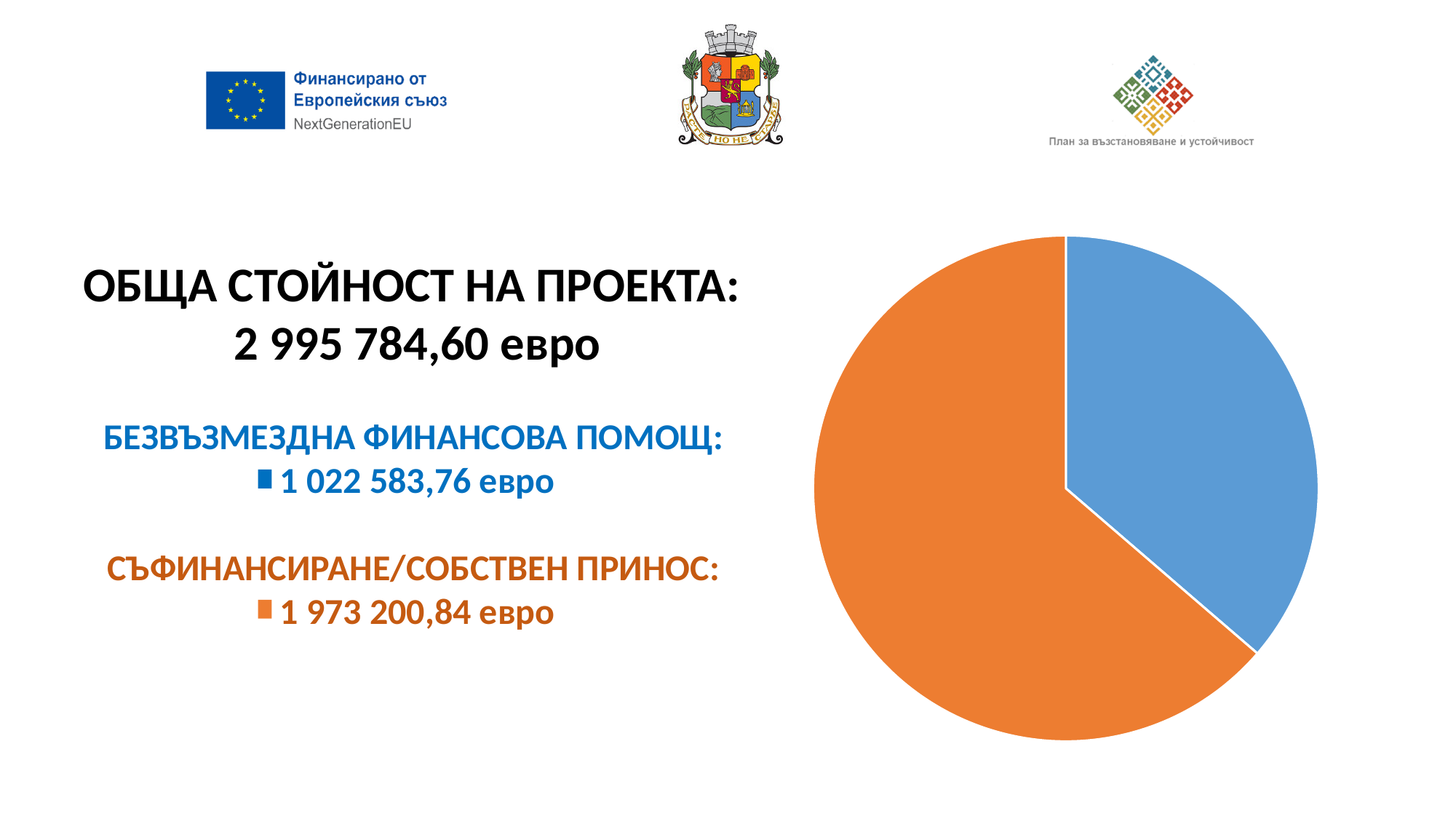
What is the difference between the value for СЪФИНАНСИРАНЕ/СОБСТВЕН ПРИНОС and the value for БЕЗВЪЗМЕЗДНА ФИНАНСОВА ПОМОЩ? 950 617,08 евро Which category has the largest slice of the pie? СЪФИНАНСИРАНЕ/СОБСТВЕН ПРИНОС How many slices does the pie chart have? 2 Which category has the smallest slice of the pie? БЕЗВЪЗМЕЗДНА ФИНАНСОВА ПОМОЩ What is the value for БЕЗВЪЗМЕЗДНА ФИНАНСОВА ПОМОЩ (the blue slice)? 1 022 583,76 евро What is the value for СЪФИНАНСИРАНЕ/СОБСТВЕН ПРИНОС (the orange slice)? 1 973 200,84 евро What kind of chart is shown on the slide? pie chart What colour is the slice for БЕЗВЪЗМЕЗДНА ФИНАНСОВА ПОМОЩ? blue What is the total value represented by the whole pie (ОБЩА СТОЙНОСТ НА ПРОЕКТА)? 2 995 784,60 евро What colour is the slice for СЪФИНАНСИРАНЕ/СОБСТВЕН ПРИНОС? orange Which category has the larger slice of the pie: БЕЗВЪЗМЕЗДНА ФИНАНСОВА ПОМОЩ or СЪФИНАНСИРАНЕ/СОБСТВЕН ПРИНОС? СЪФИНАНСИРАНЕ/СОБСТВЕН ПРИНОС